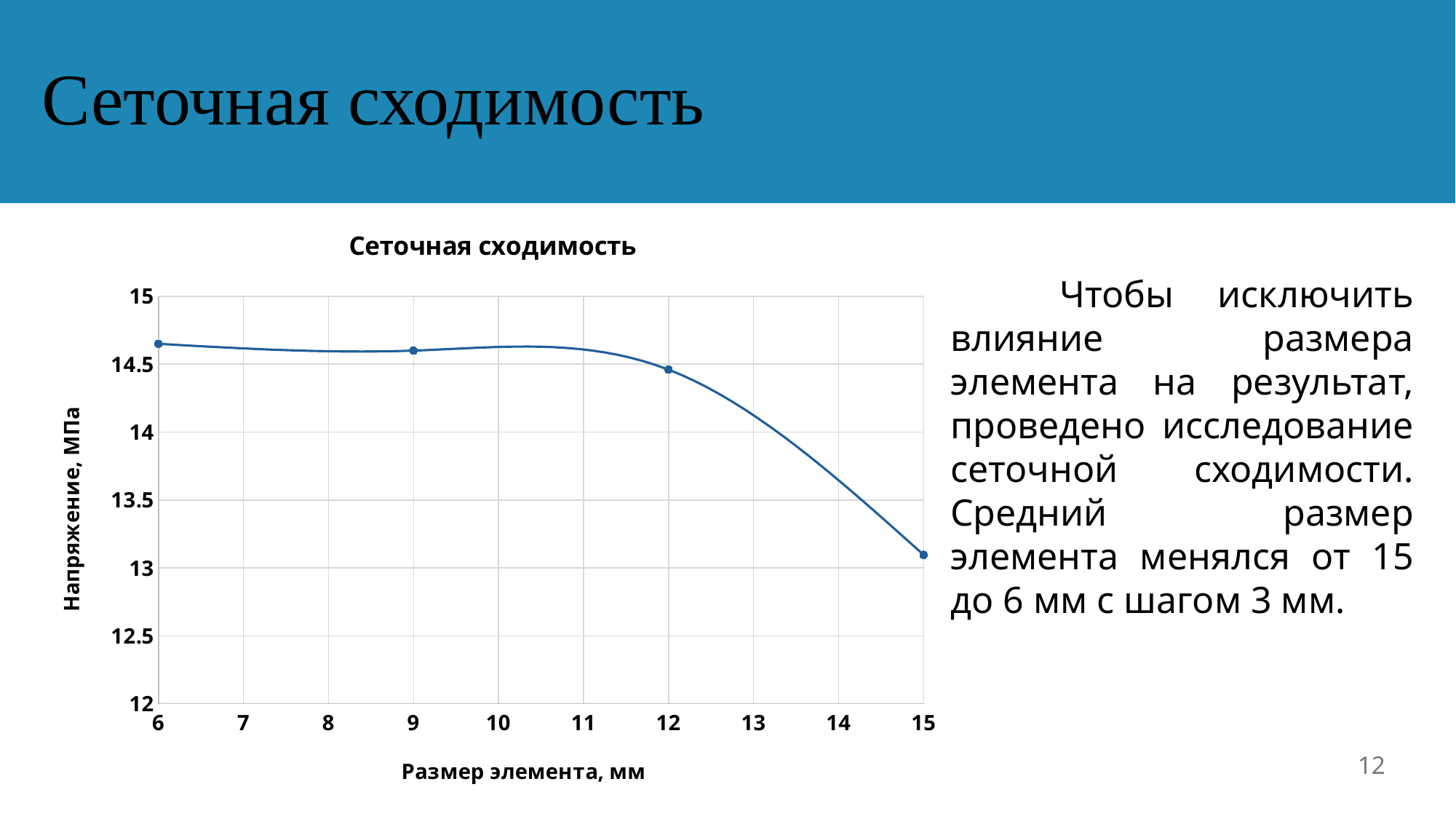
Which has the larger stress value: element size 6 мм or element size 15 мм? 6 мм How many data points are plotted on the chart? 4 Is the value at element size 12 мм greater or less than 14? greater Is the value at element size 6 мм greater or less than 14.5? greater At which element size (мм) is the stress value lowest? 15 Is the value at element size 15 мм greater or less than 13.5? less Which has the larger stress value: element size 12 мм or element size 15 мм? 12 мм What is the title of the chart? Сеточная сходимость Does the stress value rise or fall as the element size increases from 6 to 15 мм? fall What kind of chart is shown on the slide? line chart What is the label of the vertical axis of the chart? Напряжение, МПа